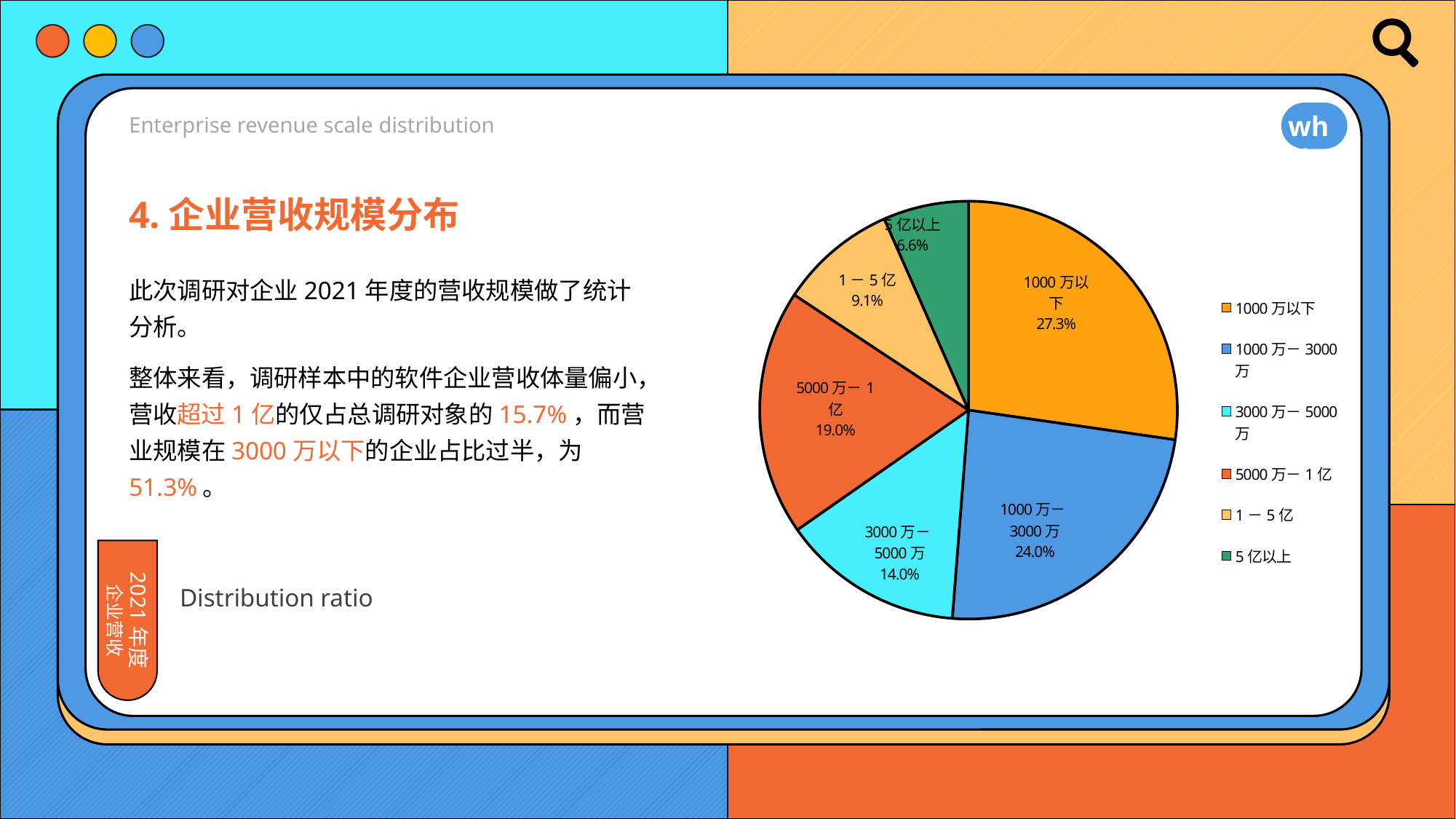
What type of chart is shown on the slide? Pie chart What is the difference between the 1000 万以下 share and the 1000 万－3000 万 share? 3.3% How many categories does the legend of the pie chart list? 6 Which is larger, the 5000 万－1 亿 slice or the 3000 万－5000 万 slice? 5000 万－1 亿 What percentage is labelled on the 3000 万－5000 万 slice? 14.0% What is the value for the 5 亿以上 slice? 6.6% What share of the pie does the 1000 万以下 slice represent? 27.3% What is the value shown for the 1000 万－3000 万 slice? 24.0% What is the value for the 5000 万－1 亿 slice? 19.0% Which category has the largest share of the pie? 1000 万以下 Which category has the smallest share of the pie? 5 亿以上 What percentage is shown for the 1－5 亿 slice? 9.1%